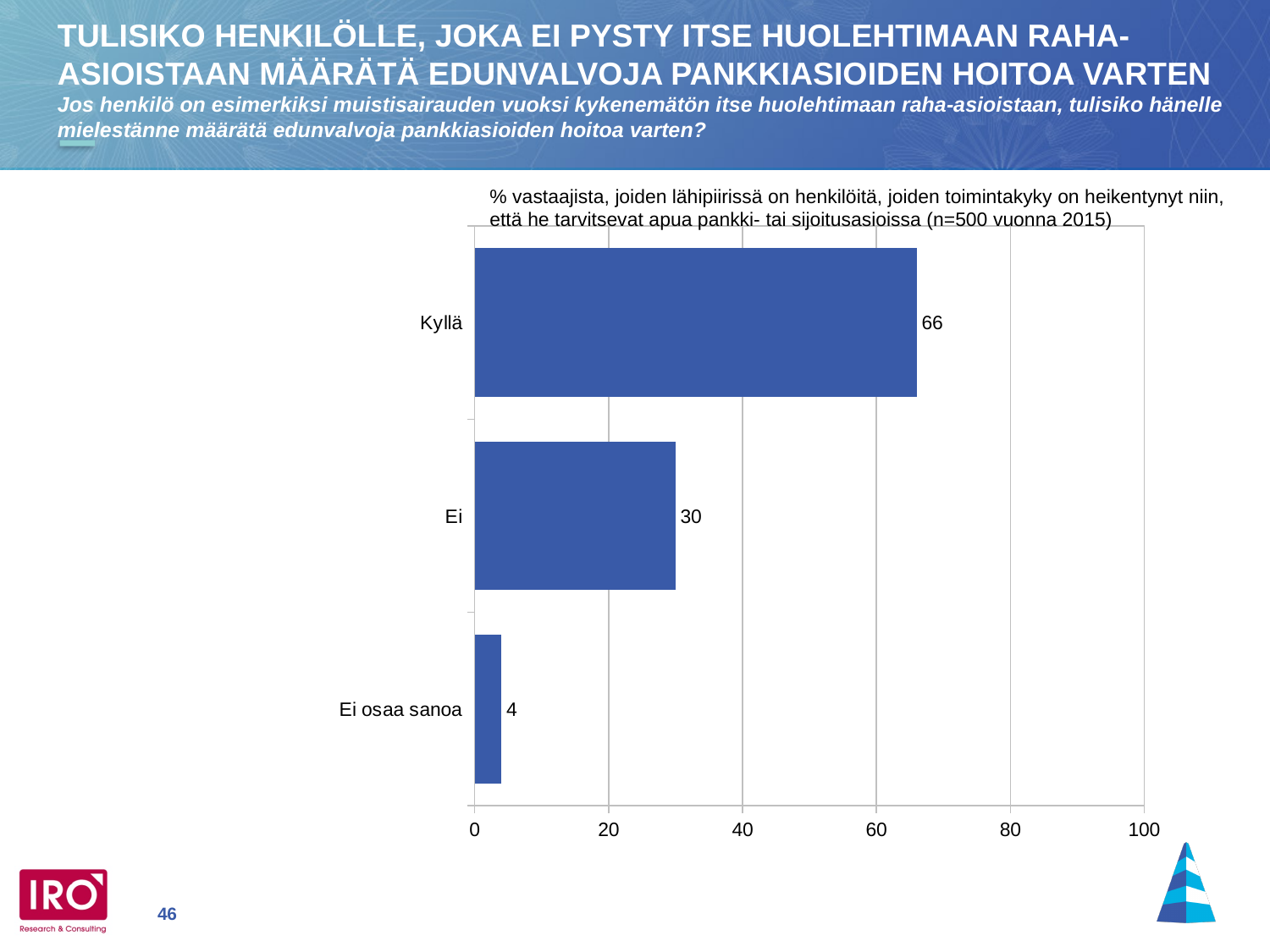
Which category has the lowest value? Ei osaa sanoa Is the value for Kyllä greater or less than 60? greater Which is larger, the value for Ei or the value for Ei osaa sanoa? Ei What is the value for Ei? 30 What kind of chart is shown on the slide? bar chart How many categories are shown in the chart? 3 What is the value for Ei osaa sanoa? 4 What is the difference between the values for Ei and Ei osaa sanoa? 26 Which category has the highest value? Kyllä What is the maximum value shown on the horizontal axis? 100 What is the value for Kyllä? 66 What is the difference between the values for Kyllä and Ei? 36